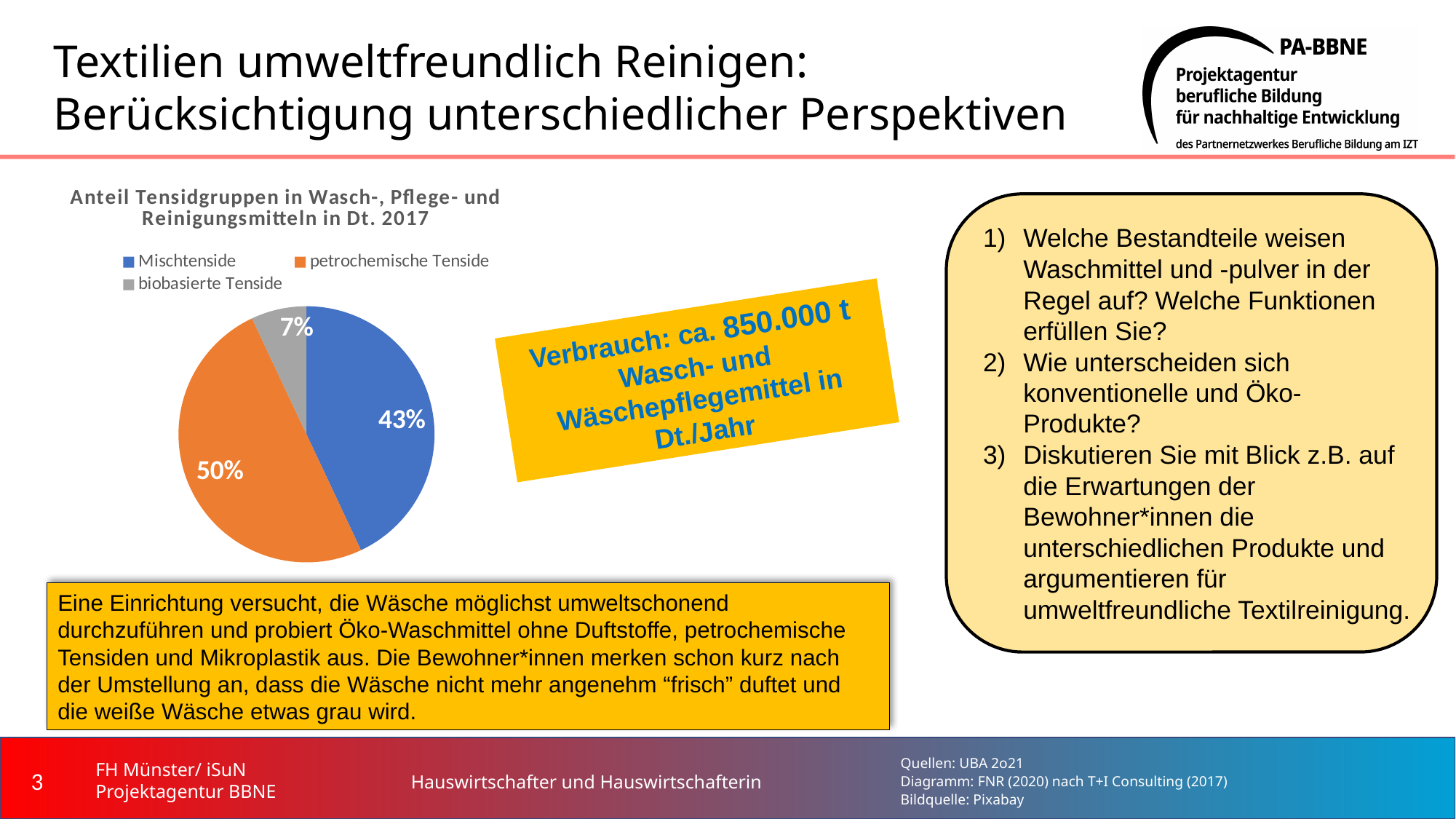
What is the title of the pie chart? Anteil Tensidgruppen in Wasch-, Pflege- und Reinigungsmitteln in Dt. 2017 Which colour represents biobasierte Tenside in the pie chart? grey Which category has the largest share of the pie? petrochemische Tenside What type of chart is shown on the slide? pie chart What is the difference in percentage points between Mischtenside and biobasierte Tenside? 36 What share of the pie is petrochemische Tenside? 50% Which category has the smallest share of the pie? biobasierte Tenside What share of the pie is biobasierte Tenside? 7% Which is larger, the share of Mischtenside or the share of biobasierte Tenside? Mischtenside What share of the pie is Mischtenside? 43% How many categories does the pie chart show? 3 What is the difference in percentage points between petrochemische Tenside and Mischtenside? 7